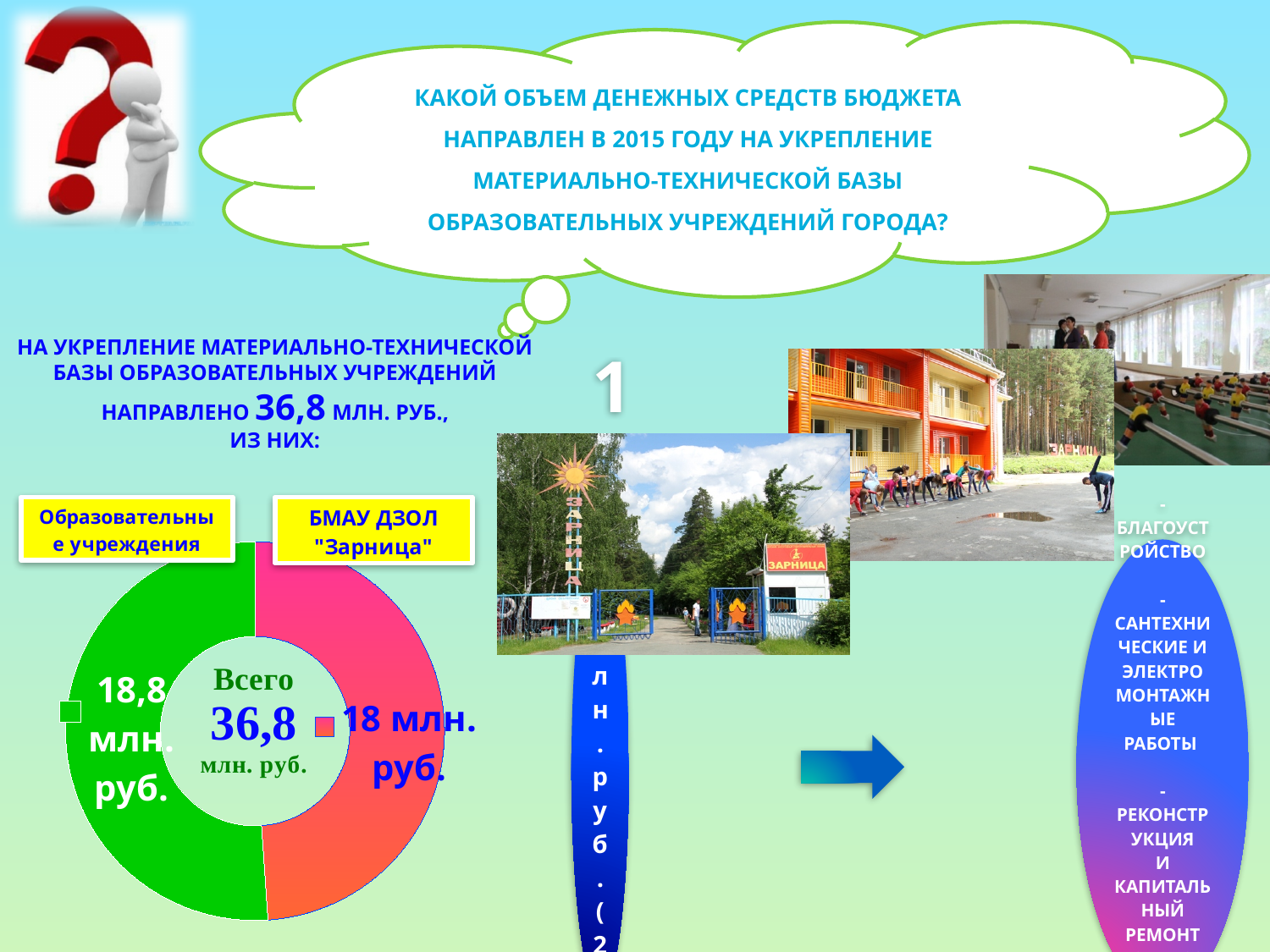
What is the difference between the values for Образовательные учреждения and БМАУ ДЗОЛ "Зарница"? 0,8 млн. руб. How many slices does the donut chart have? 2 What value is shown for Образовательные учреждения in the donut chart? 18,8 млн. руб. Which category has the smallest value in the donut chart? БМАУ ДЗОЛ "Зарница" What kind of chart is shown on the slide? Pie (donut) chart What colour is the slice for БМАУ ДЗОЛ "Зарница" in the donut chart? Pink/red What total is printed in the centre of the donut chart? 36,8 млн. руб. Which slice of the donut chart is larger: Образовательные учреждения or БМАУ ДЗОЛ "Зарница"? Образовательные учреждения What value is shown for БМАУ ДЗОЛ "Зарница" in the donut chart? 18 млн. руб. What colour is the slice for Образовательные учреждения in the donut chart? Green